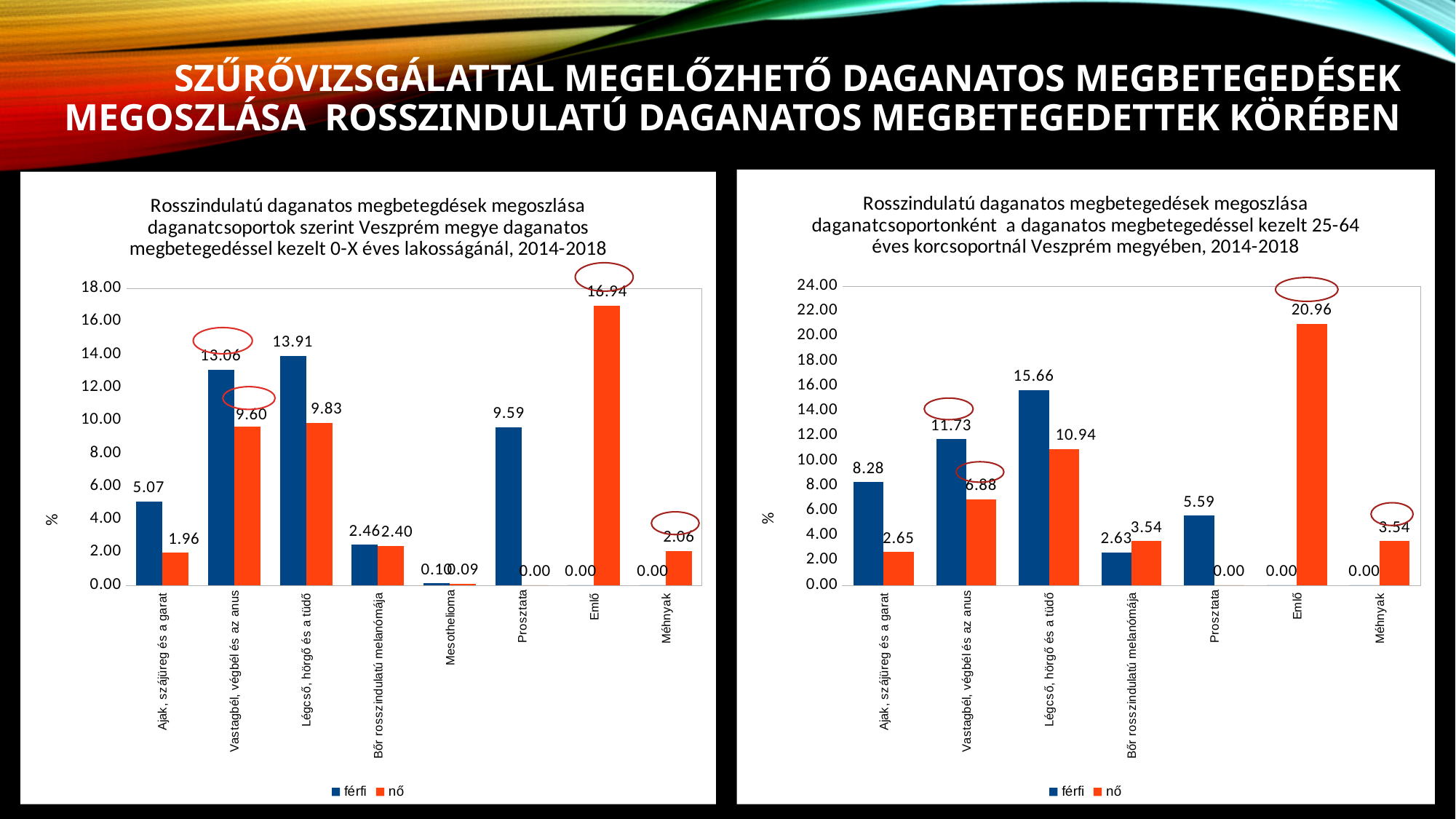
On the right chart, what is the value for férfi in the Ajak, szájüreg és a garat category? 8.28 On the left chart, which category has the highest value for nő? Emlő How many categories are shown on the x axis of the left chart? 8 On the right chart, what is the difference between the férfi and nő values in the Légcső, hörgő és tüdő category? 4.72 How many series does the legend of the right chart list? 2 On the left chart, what is the difference between the férfi and nő values in the Vastagbél, végbél és az anus category? 3.46 On the left chart, what is the value for nő in the Emlő category? 16.94 On the right chart, which category has the highest value for férfi? Légcső, hörgő és tüdő On the left chart, what is the value for férfi in the Légcső, hörgő és tüdő category? 13.91 On the right chart, which is larger in the Bőr rosszindulatú melanómája category, férfi or nő? nő What type of chart is the left chart? Bar chart On the right chart, what is the value for nő in the Emlő category? 20.96